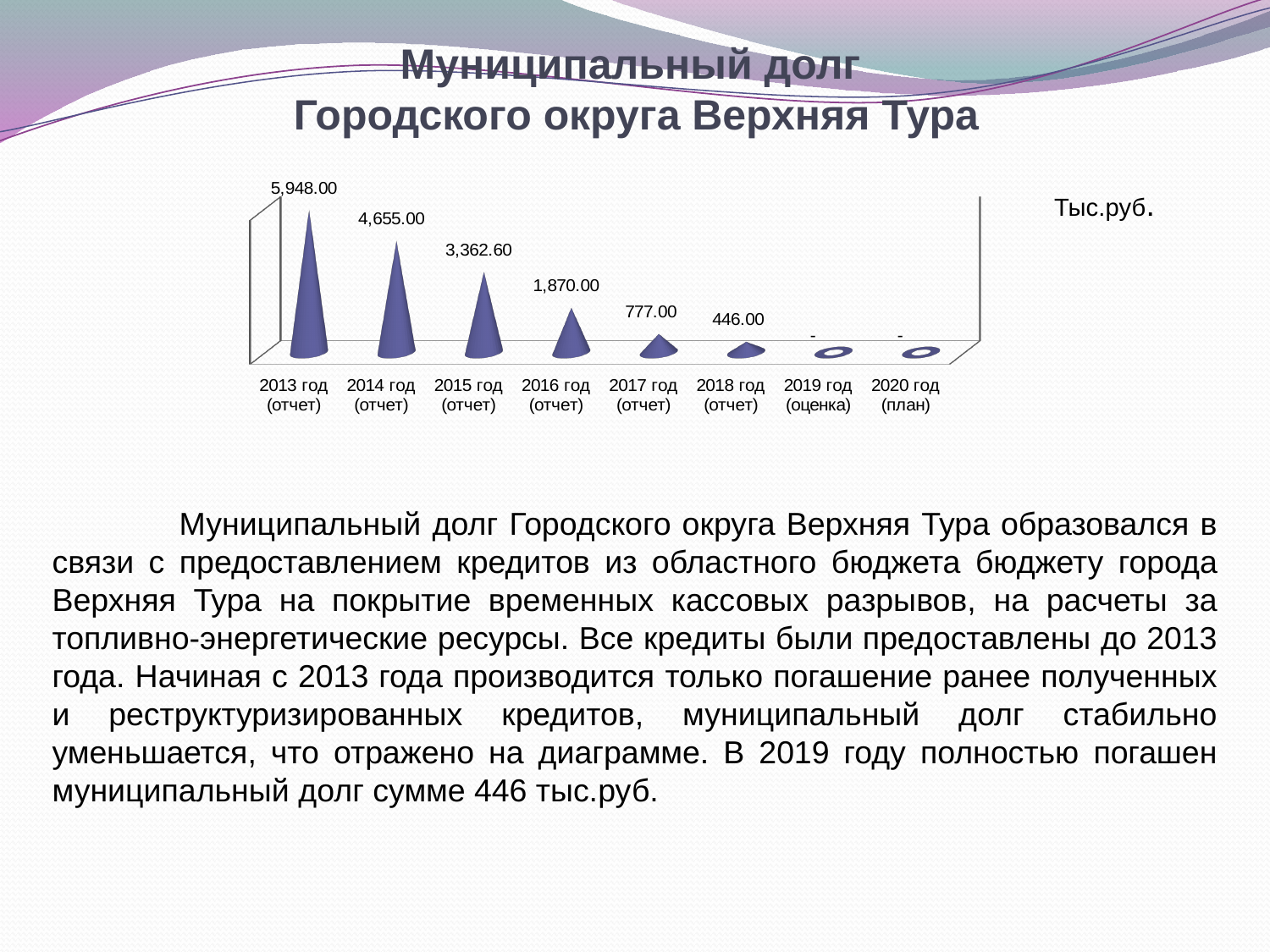
What is the municipal debt value shown for 2013 год (отчет)? 5,948.00 What is the value shown for 2015 год (отчет)? 3,362.60 Which year has the highest municipal debt on the chart? 2013 год (отчет) Which is larger, the value for 2015 год (отчет) or the value for 2016 год (отчет)? 2015 год (отчет) What is the difference between the values for 2013 год (отчет) and 2014 год (отчет)? 1,293.00 What unit of measurement is indicated next to the chart? Тыс.руб. How many year categories are shown on the x axis of the chart? 8 What is the difference between the values for 2017 год (отчет) and 2018 год (отчет)? 331.00 What kind of chart is used on the slide? Bar chart (3D cone bars) Do the values rise or fall from 2013 to 2018 along the x axis? Fall What is the value shown for 2016 год (отчет)? 1,870.00 What is the value shown for 2018 год (отчет)? 446.00